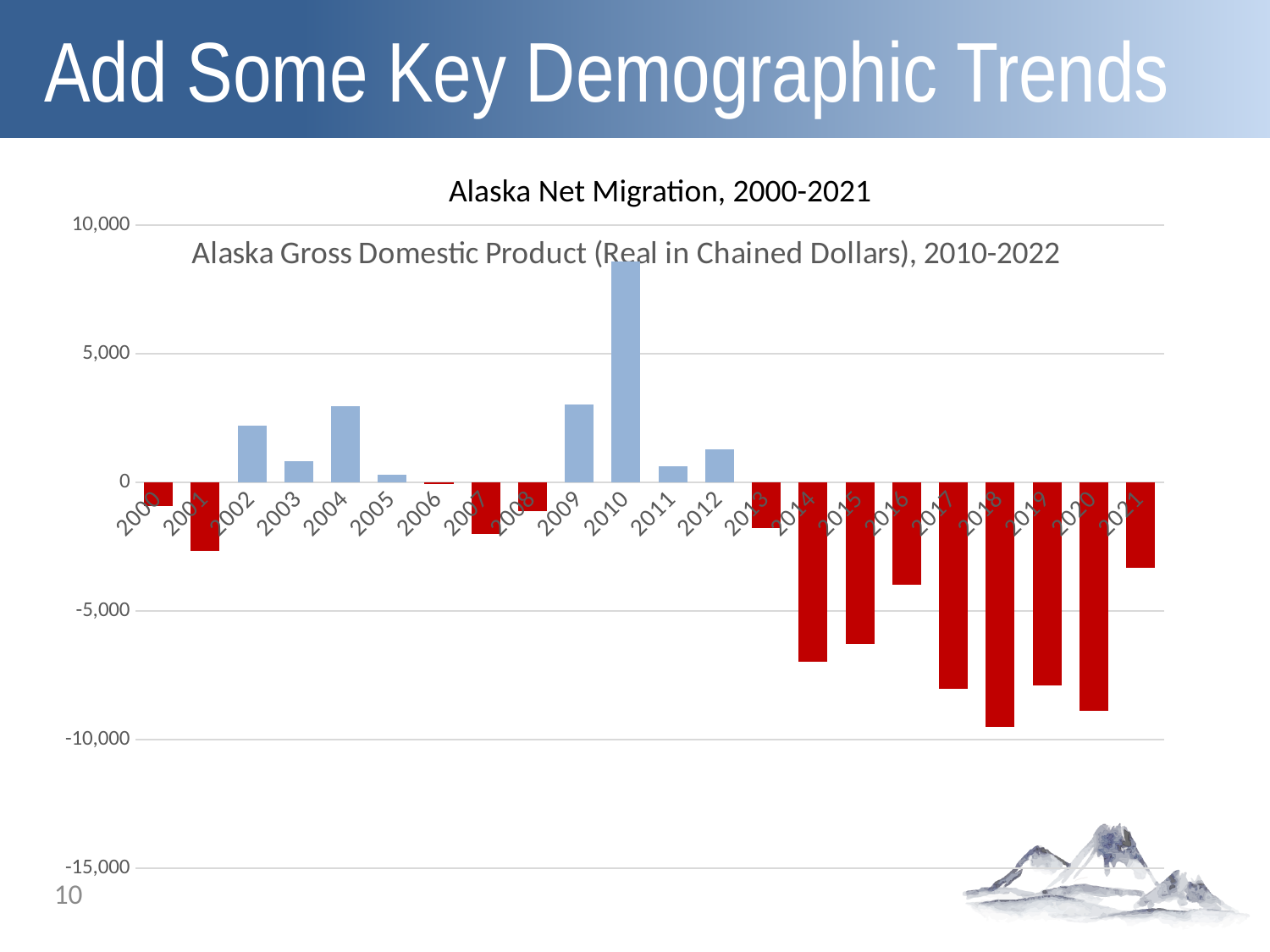
Is the value for 2018 greater or less than -10,000? greater How many years are plotted on the x axis of the chart? 22 What kind of chart is shown on the slide? bar chart What is the title of the chart? Alaska Net Migration, 2000-2021 Which year has the highest net migration value? 2010 Which year has the lowest net migration value? 2018 Which year has the larger net migration value, 2004 or 2005? 2004 What colour are the bars for years with negative net migration? red Which year has the larger net migration value, 2016 or 2017? 2016 Is the value for 2010 greater or less than 5,000? greater Is the value for 2016 greater or less than -5,000? greater